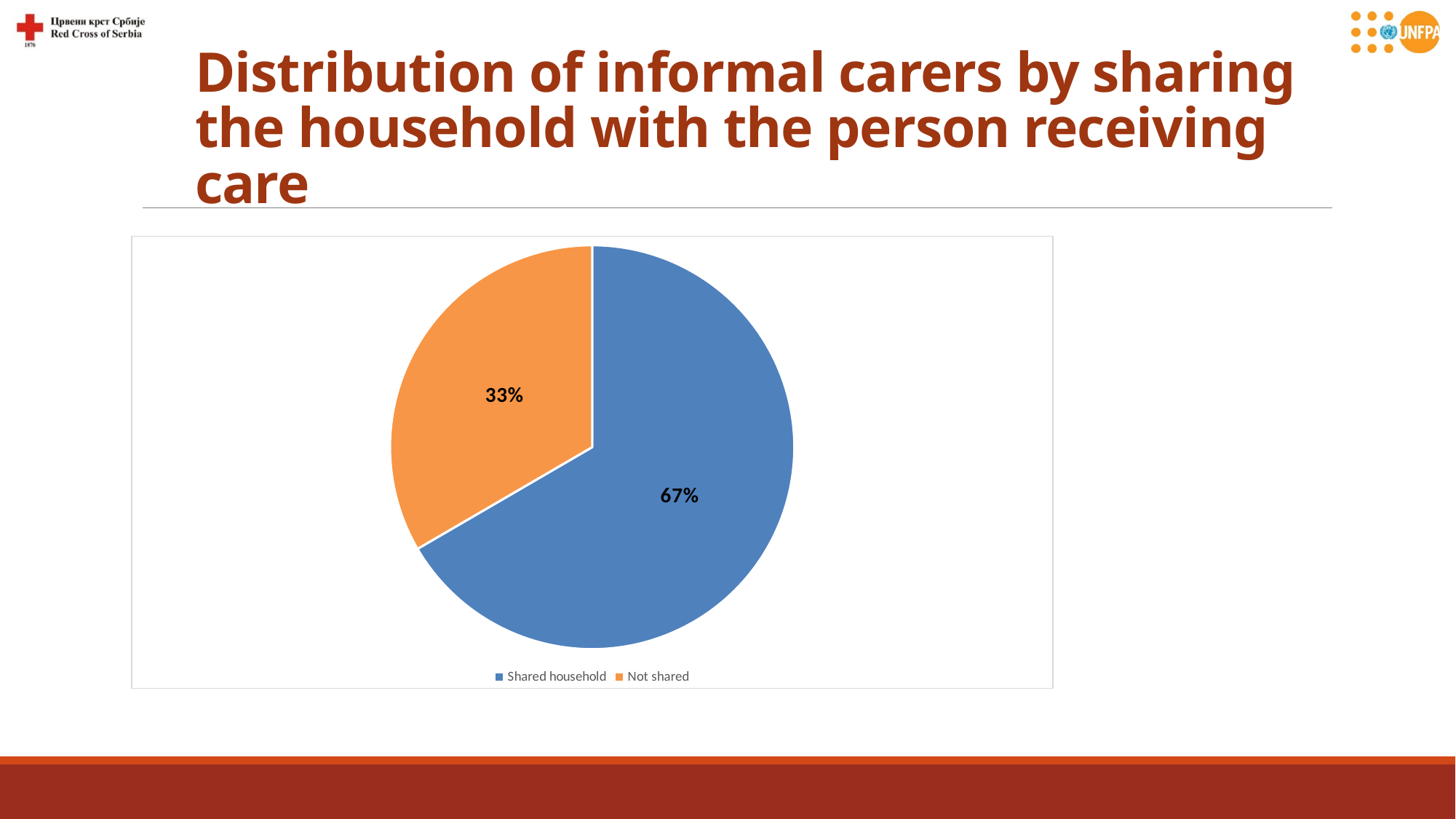
What colour is the Shared household slice? blue How many slices does the pie chart have? 2 Which category has the smallest share of the pie? Not shared What percentage of informal carers do not share the household with the person receiving care? 33% What type of chart is shown on the slide? pie chart What share of the pie does the Not shared slice represent? 33% What percentage of informal carers share the household with the person receiving care? 67% Which is larger, the Shared household slice or the Not shared slice? Shared household Which category has the largest share of the pie? Shared household What is the difference in percentage points between the Shared household and Not shared slices? 34 What colour is the Not shared slice? orange How many entries does the legend list? 2